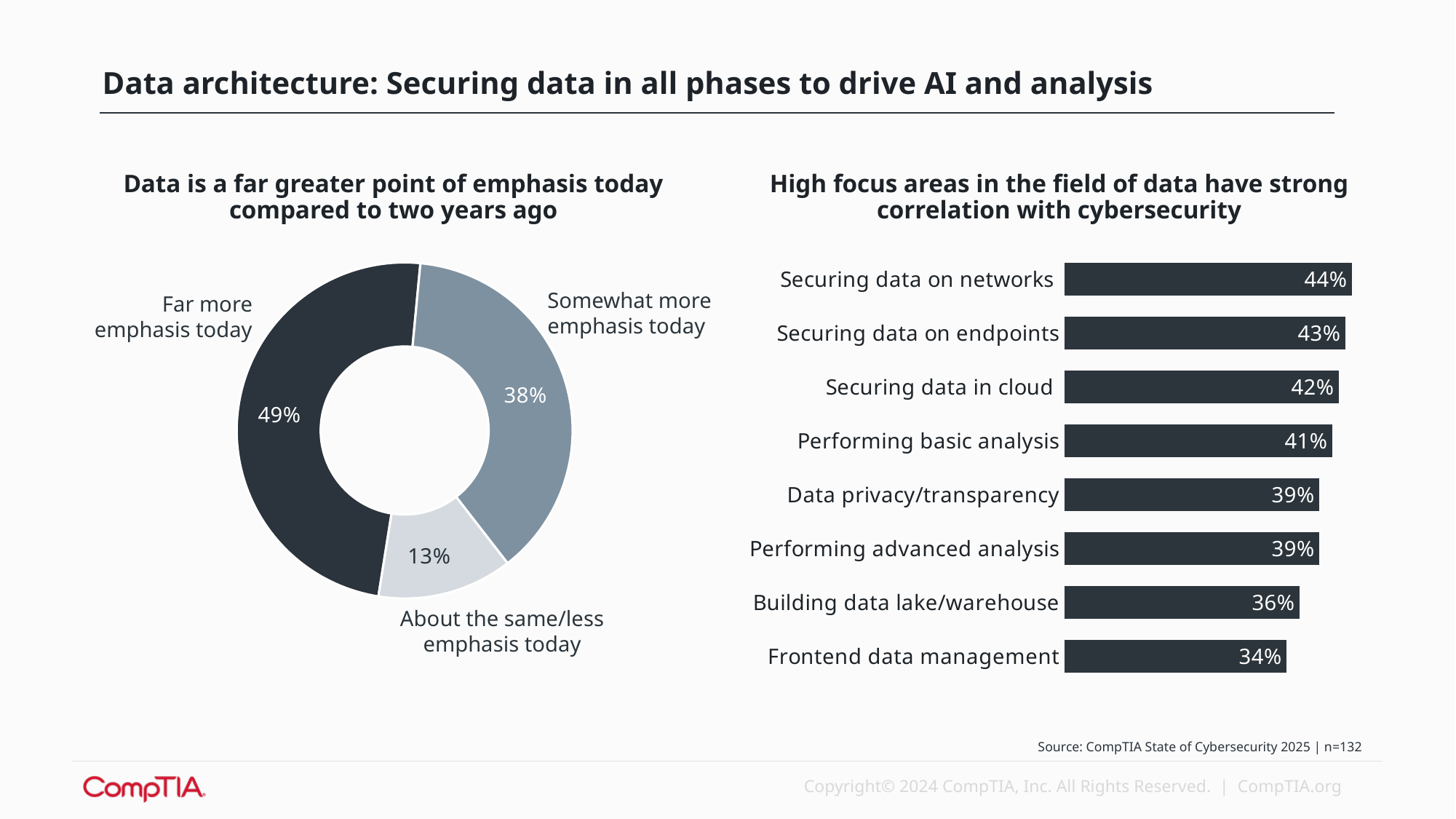
In the left chart, what is the difference between "Far more emphasis today" and "Somewhat more emphasis today"? 11 percentage points How many focus areas are listed in the right chart? 8 In the right chart ("High focus areas in the field of data have strong correlation with cybersecurity"), what is the value for "Securing data in cloud"? 42% In the left chart ("Data is a far greater point of emphasis today compared to two years ago"), what share of respondents said there is far more emphasis today? 49% How many categories does the left chart show? 3 What kind of chart is the right chart? Bar chart In the right chart, which focus area has the highest value? Securing data on networks In the left chart, which category has the smallest share? About the same/less emphasis today In the left chart, what percentage corresponds to "About the same/less emphasis today"? 13% What kind of chart is the left chart? Doughnut (pie) chart In the right chart, what is the difference between "Securing data on networks" and "Frontend data management"? 10 percentage points In the right chart, which focus area has the lowest value? Frontend data management